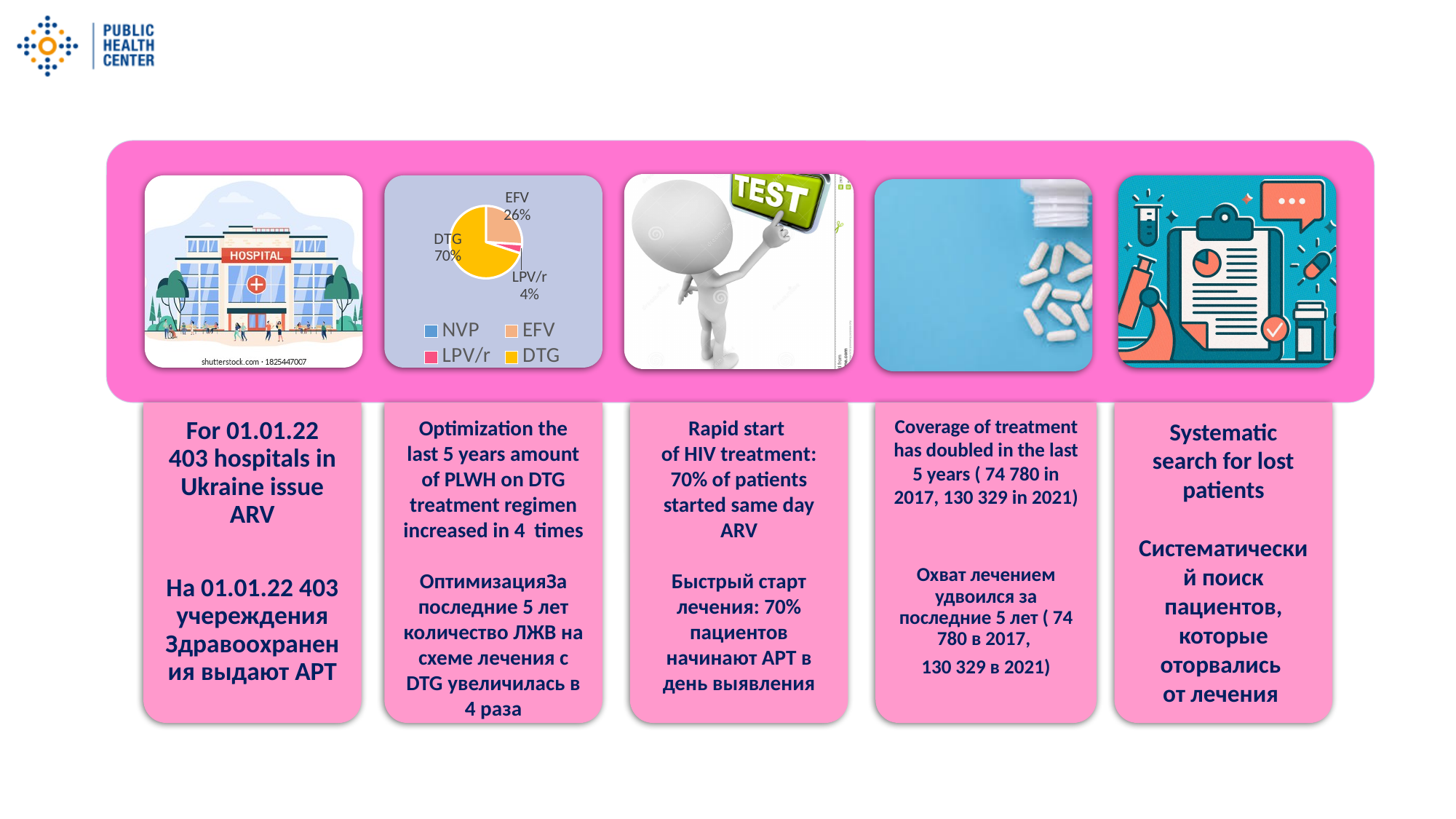
What percentage does the DTG slice represent in the pie chart? 70% Which regimen has the largest slice in the pie chart? DTG How many entries does the legend of the pie chart list? 4 Which labelled slice in the pie chart is the smallest? LPV/r What percentage does the EFV slice represent in the pie chart? 26% What percentage does the LPV/r slice represent in the pie chart? 4% Which slice is larger in the pie chart, EFV or LPV/r? EFV What colour is the DTG slice in the pie chart? yellow What type of chart is shown on the slide? pie chart What is the difference in percentage points between the DTG and EFV slices? 44 What is the difference in percentage points between the EFV and LPV/r slices? 22 Which legend entry in the pie chart has no visible labelled slice? NVP